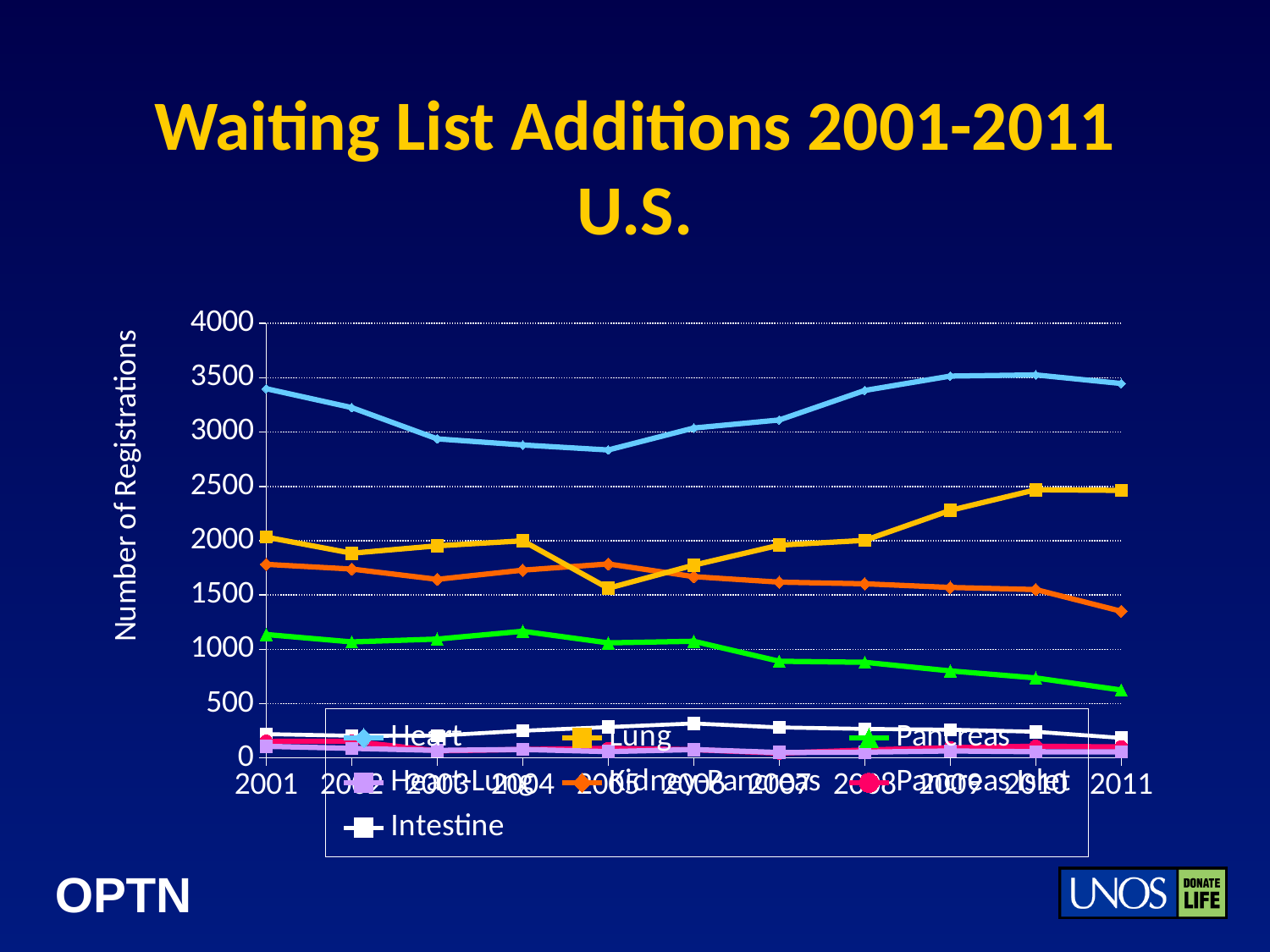
Is the value for Lung in 2005 greater or less than 2000? less In 2011, which is larger: Lung or Kidney-Pancreas? Lung Is the value for Heart in 2005 greater or less than 3000? less How many series does the legend list? 7 What is the title of the y axis? Number of Registrations Is the value for Heart in 2001 greater or less than 3000? greater What kind of chart is shown on the slide? line chart Does the Pancreas series rise or fall from 2001 to 2011? fall Which series has the highest value in 2011? Heart How many years are plotted along the x axis? 11